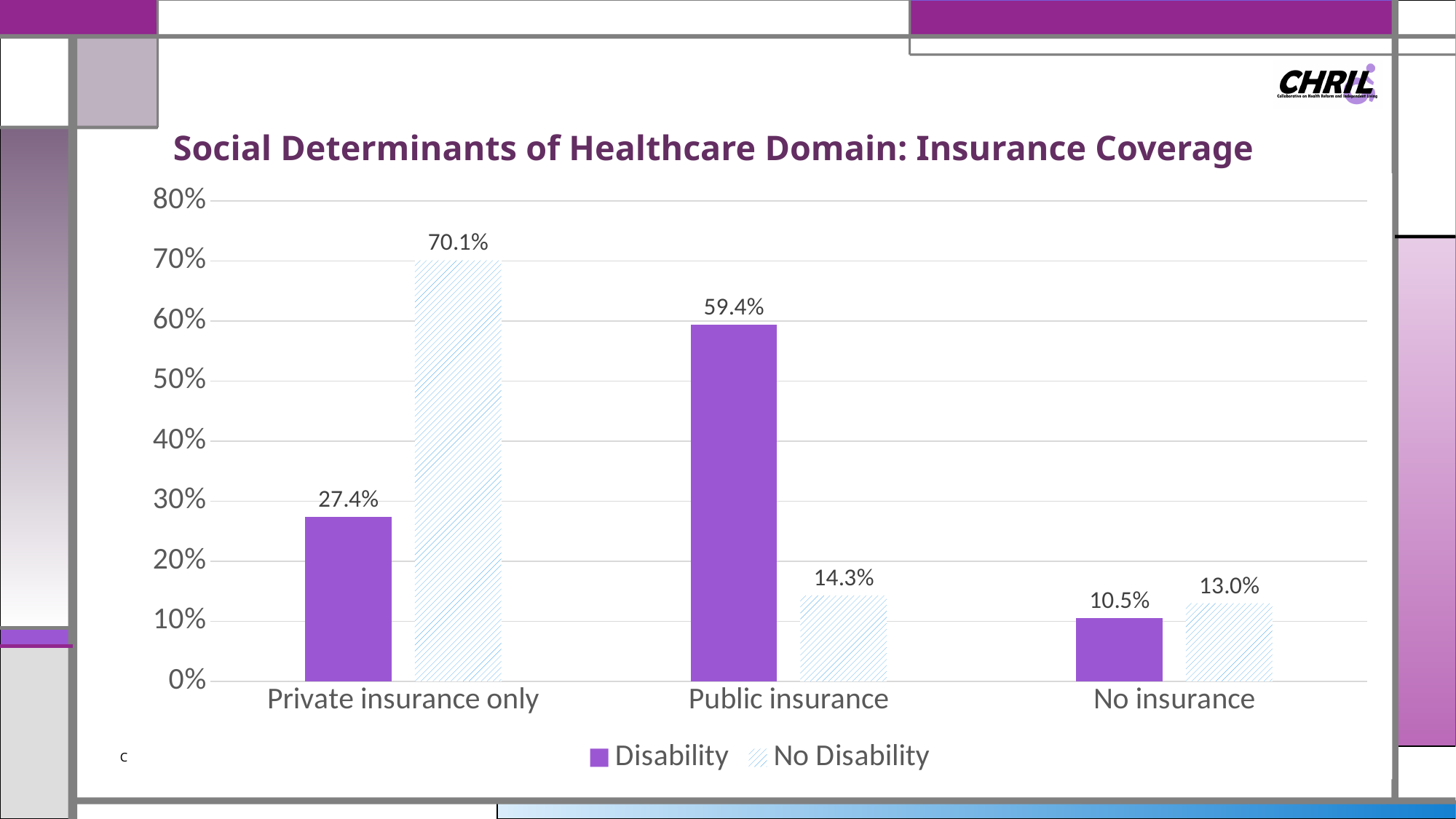
What is the value for No Disability in the No insurance category? 13.0% Is the value for Disability in Public insurance greater or less than 50%? greater Which category has the highest value for the Disability series? Public insurance What is the value for No Disability in the Public insurance category? 14.3% Which is larger in the No insurance category: Disability or No Disability? No Disability What is the value for Disability in the Private insurance only category? 27.4% Which category has the lowest value for the No Disability series? No insurance What is the difference between the No Disability and Disability values for Private insurance only? 42.7% How many series does the legend list? 2 What kind of chart is shown on the slide? Bar chart What is the difference between the Disability and No Disability values for Public insurance? 45.1% How many categories are shown on the x axis? 3